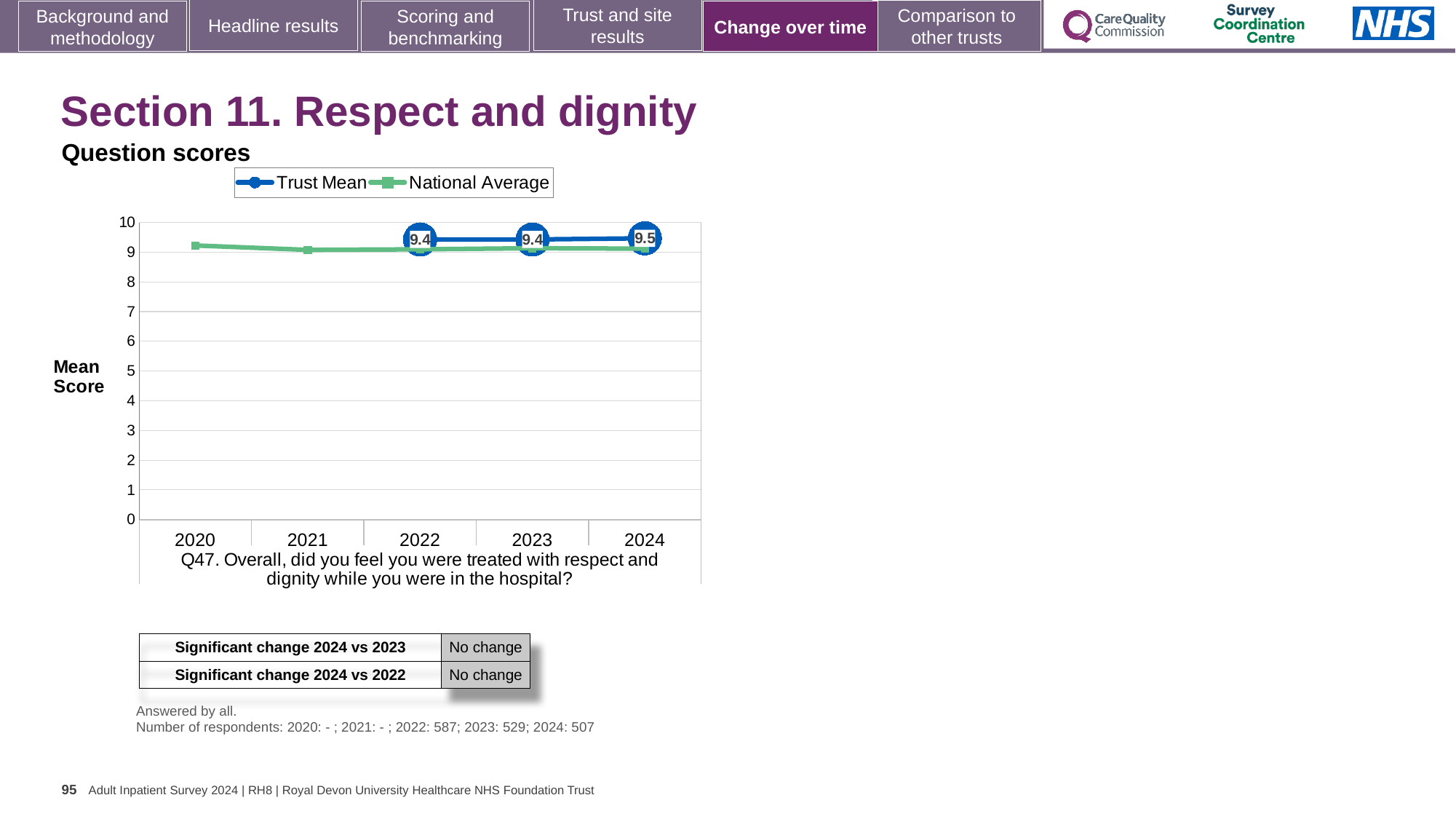
Does the Trust Mean score rise or fall from 2022 to 2024? Rise What is the Trust Mean score for 2022? 9.4 What is the Trust Mean score for 2024? 9.5 What is the difference between the Trust Mean score in 2024 and in 2022? 0.1 How many series does the legend list? 2 In which year is the Trust Mean score highest? 2024 What is the Trust Mean score for 2023? 9.4 What kind of chart is shown? Line chart Is the National Average value for 2020 greater or less than 8? greater Is the National Average value for 2024 greater or less than 10? less How many years are shown on the x axis? 5 Which is larger, the Trust Mean score for 2024 or for 2023? 2024